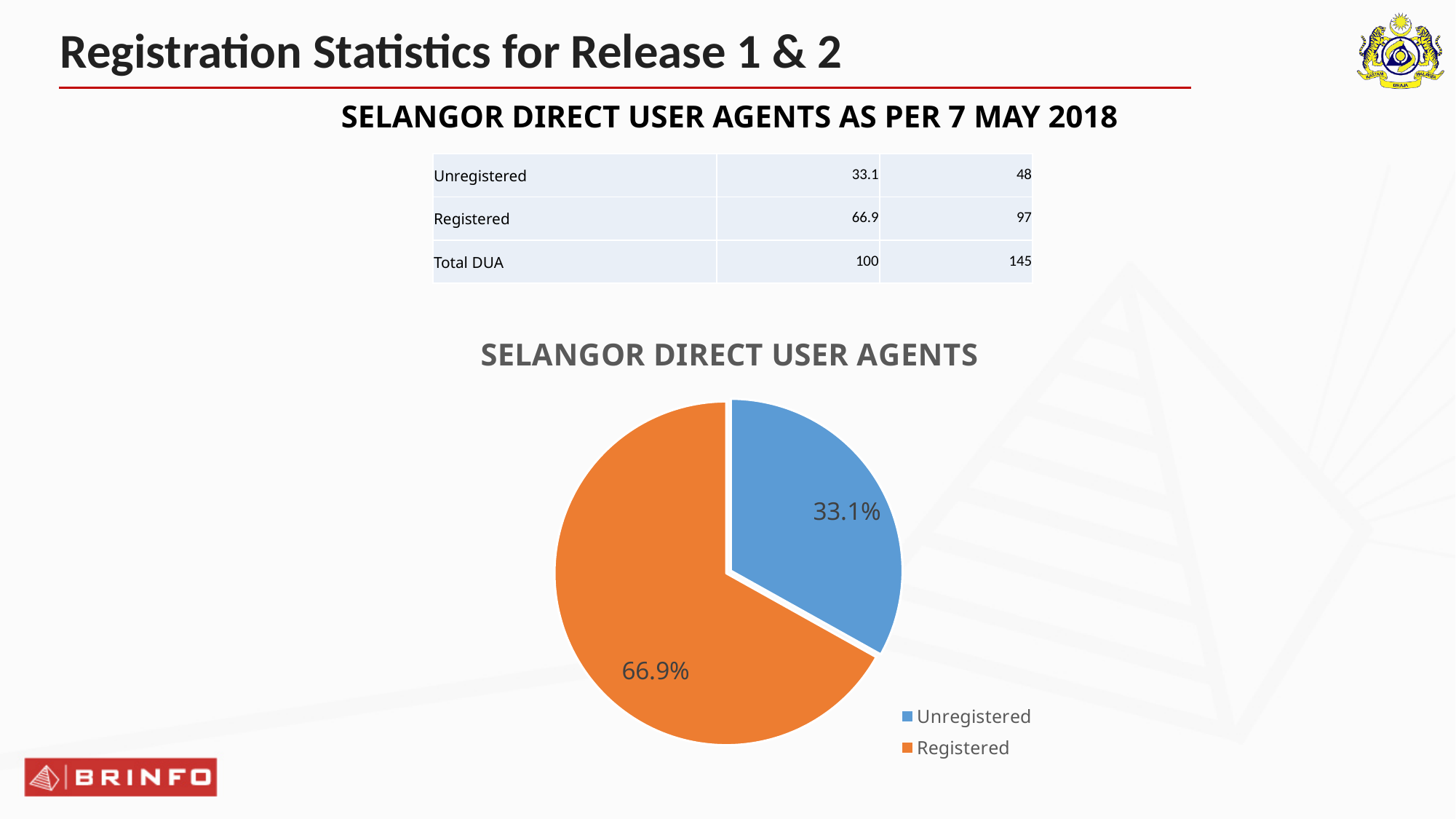
What share of the pie does the Unregistered slice represent? 33.1% Which slice of the pie is the largest? Registered What kind of chart is shown on the slide? pie chart What percentage of the pie is labelled for Registered? 66.9% What is the title of the chart? SELANGOR DIRECT USER AGENTS What percentage of the pie is labelled for Unregistered? 33.1% What colour is the Registered slice in the pie chart? orange What is the difference in percentage points between the Registered and Unregistered slices? 33.8 Which slice of the pie is the smallest? Unregistered How many slices does the pie chart have? 2 Which is larger, the Registered slice or the Unregistered slice? Registered How many entries does the legend list? 2